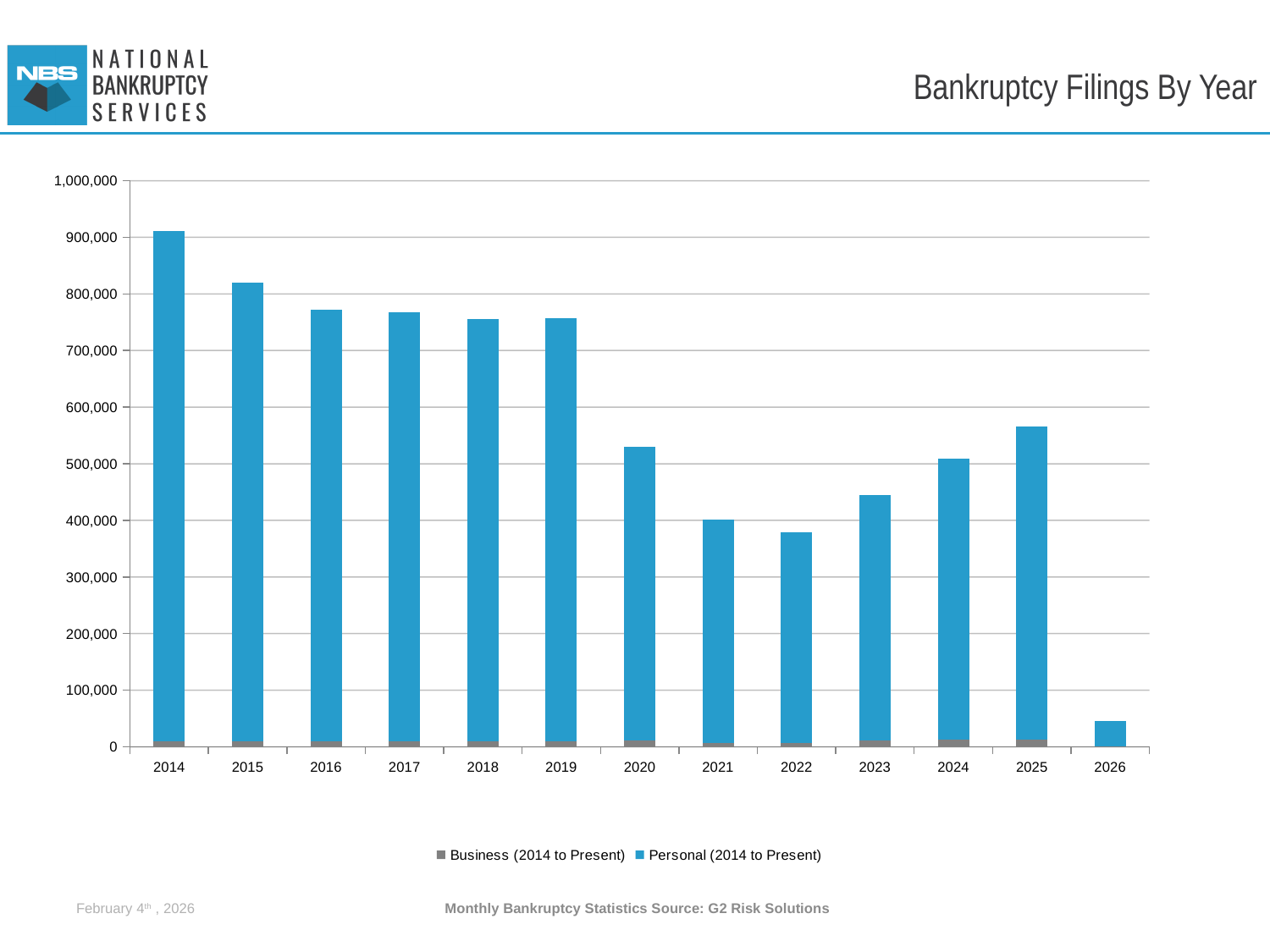
Is the total value for 2022 greater or less than 400,000? less What kind of chart is shown on the slide? Bar chart Is the total value for 2025 greater or less than 500,000? greater Which year has the lowest total bankruptcy filings? 2026 Is the total value for 2014 greater or less than 800,000? greater Do the total filings rise or fall from 2022 to 2025? rise What is the title of the chart on the slide? Bankruptcy Filings By Year How many years are shown on the x axis of the chart? 13 How many series does the legend list? 2 Which year has the larger total, 2024 or 2025? 2025 Which year has the highest total bankruptcy filings? 2014